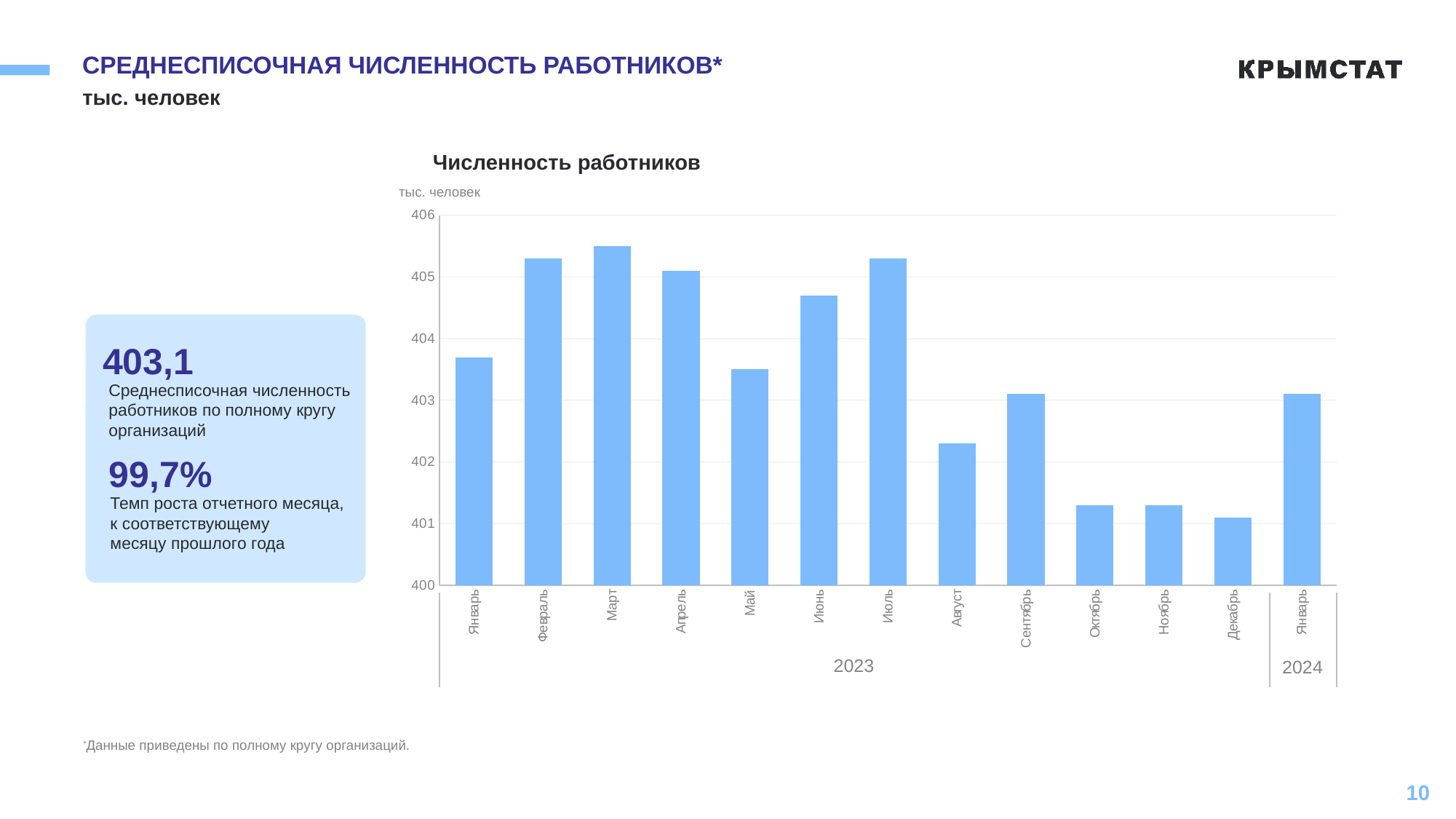
Which is larger, the value for Февраль or the value for Август? Февраль Is the value for Июнь greater or less than 405? less Is the value for Январь 2023 greater or less than 403? greater Which is larger, the value for Апрель or the value for Май? Апрель Which month has the highest value in the chart? Март Is the value for Ноябрь greater or less than 402? less How many months (bars) are plotted in the chart? 13 What is the title of the chart? Численность работников What kind of chart is shown on the slide? bar chart Do the values rise or fall from Июль to Декабрь? fall